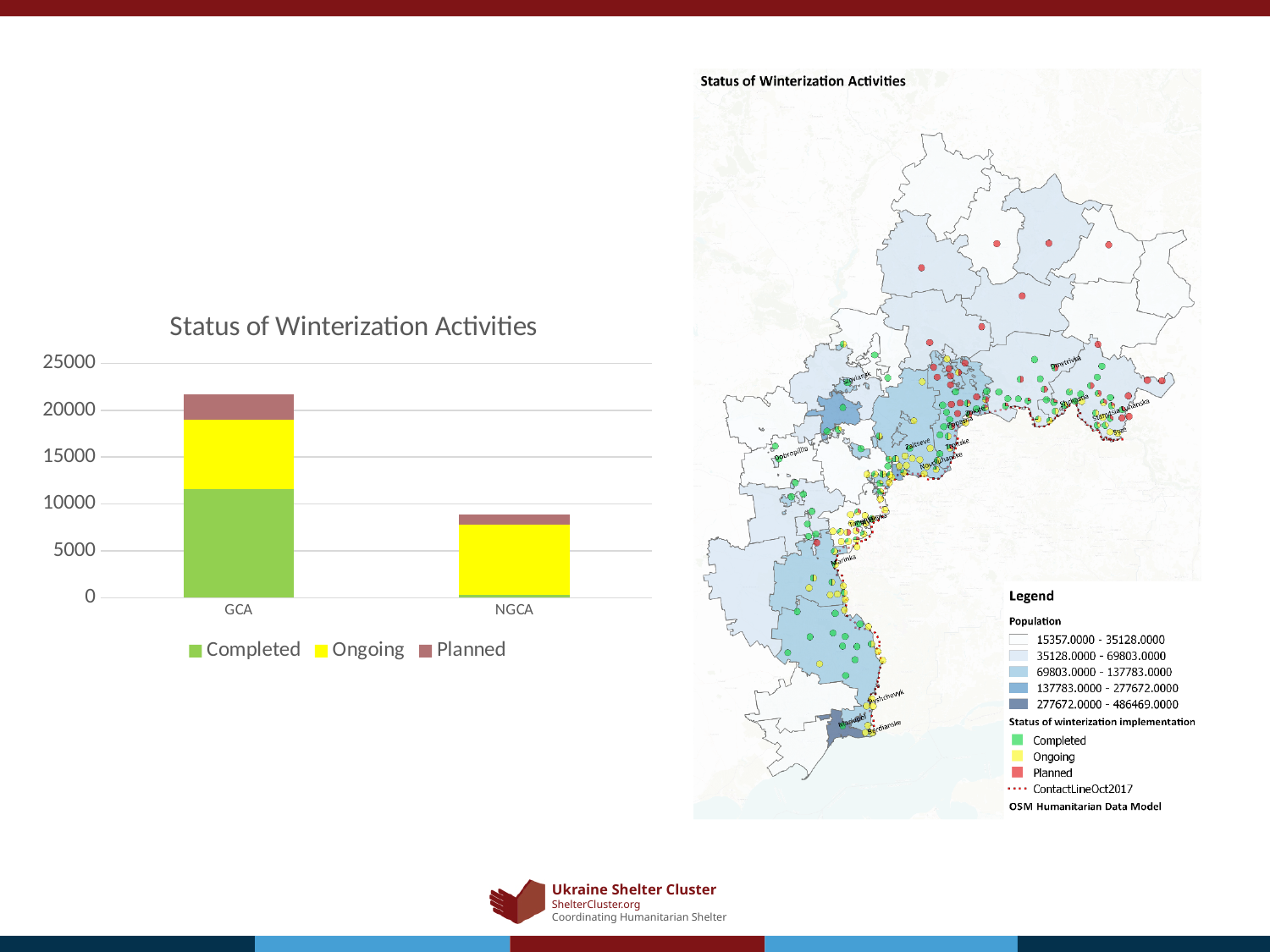
In the bar chart, which series makes up the smallest part of the GCA bar? Planned How many categories are shown on the x axis of the bar chart? 2 Which category in the bar chart has the taller stacked bar, GCA or NGCA? GCA In the bar chart, is the total stacked value for GCA greater or less than 20000? greater In the bar chart, is the Completed value for GCA greater or less than 10000? greater Which colour represents the Ongoing series in the bar chart? Yellow In the bar chart, which series makes up the largest part of the NGCA bar? Ongoing In the bar chart, is the Completed value for NGCA greater or less than 5000? less What are the series listed in the legend of the bar chart? Completed, Ongoing, Planned How many series does the legend of the bar chart list? 3 What kind of chart is the 'Status of Winterization Activities' chart on the left of the slide? Stacked bar chart